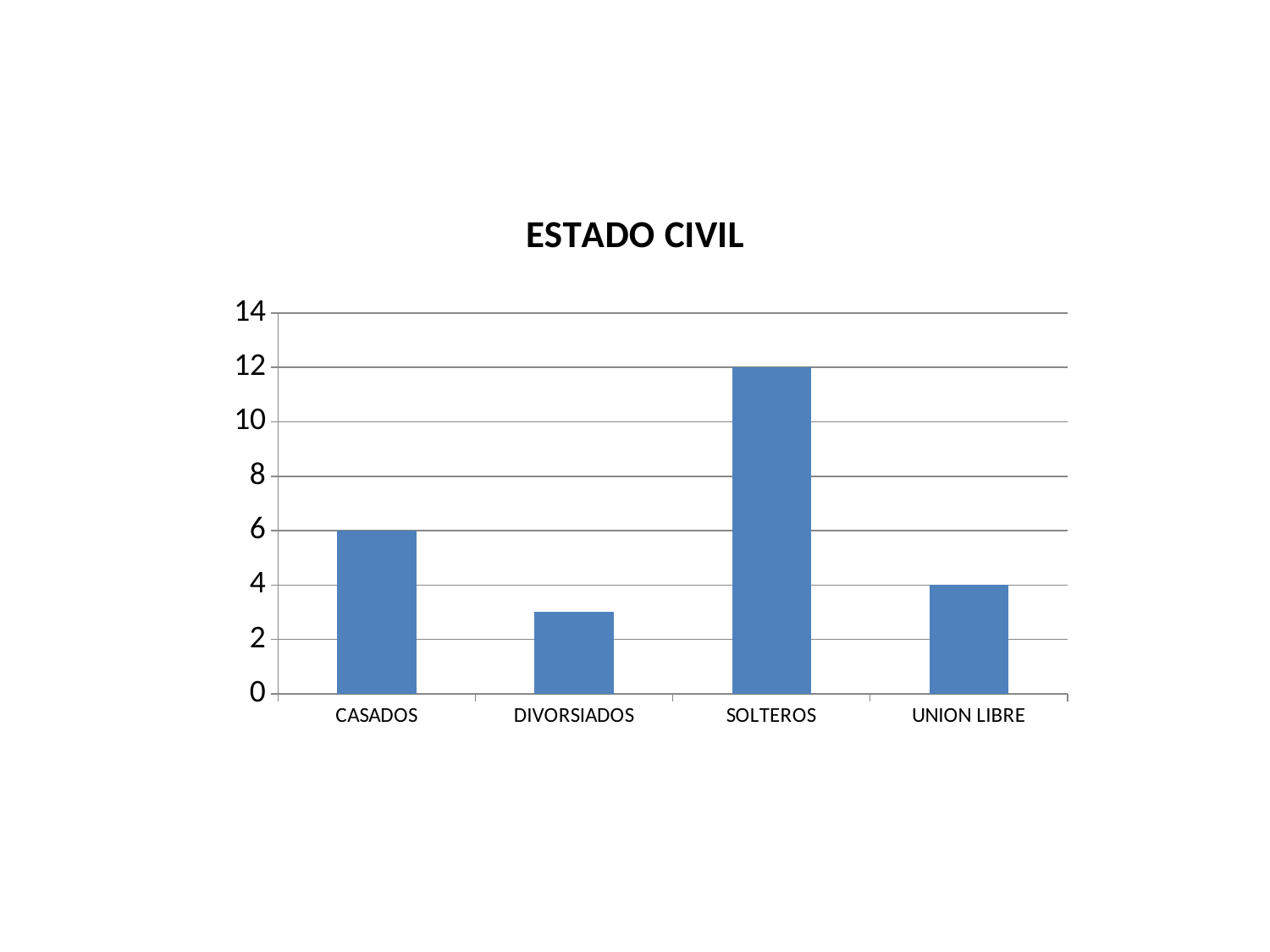
What is the difference between the values for SOLTEROS and CASADOS? 6 Which is larger, the value for CASADOS or the value for UNION LIBRE? CASADOS What is the value for SOLTEROS? 12 How many categories are shown on the x axis of the chart? 4 What type of chart is shown on the slide? bar chart Which category has the highest value? SOLTEROS Is the value for DIVORSIADOS greater or less than 2? greater What is the title of the chart? ESTADO CIVIL Which category has the lowest value? DIVORSIADOS What is the value for CASADOS? 6 What is the value for UNION LIBRE? 4 Is the value for DIVORSIADOS greater or less than 4? less